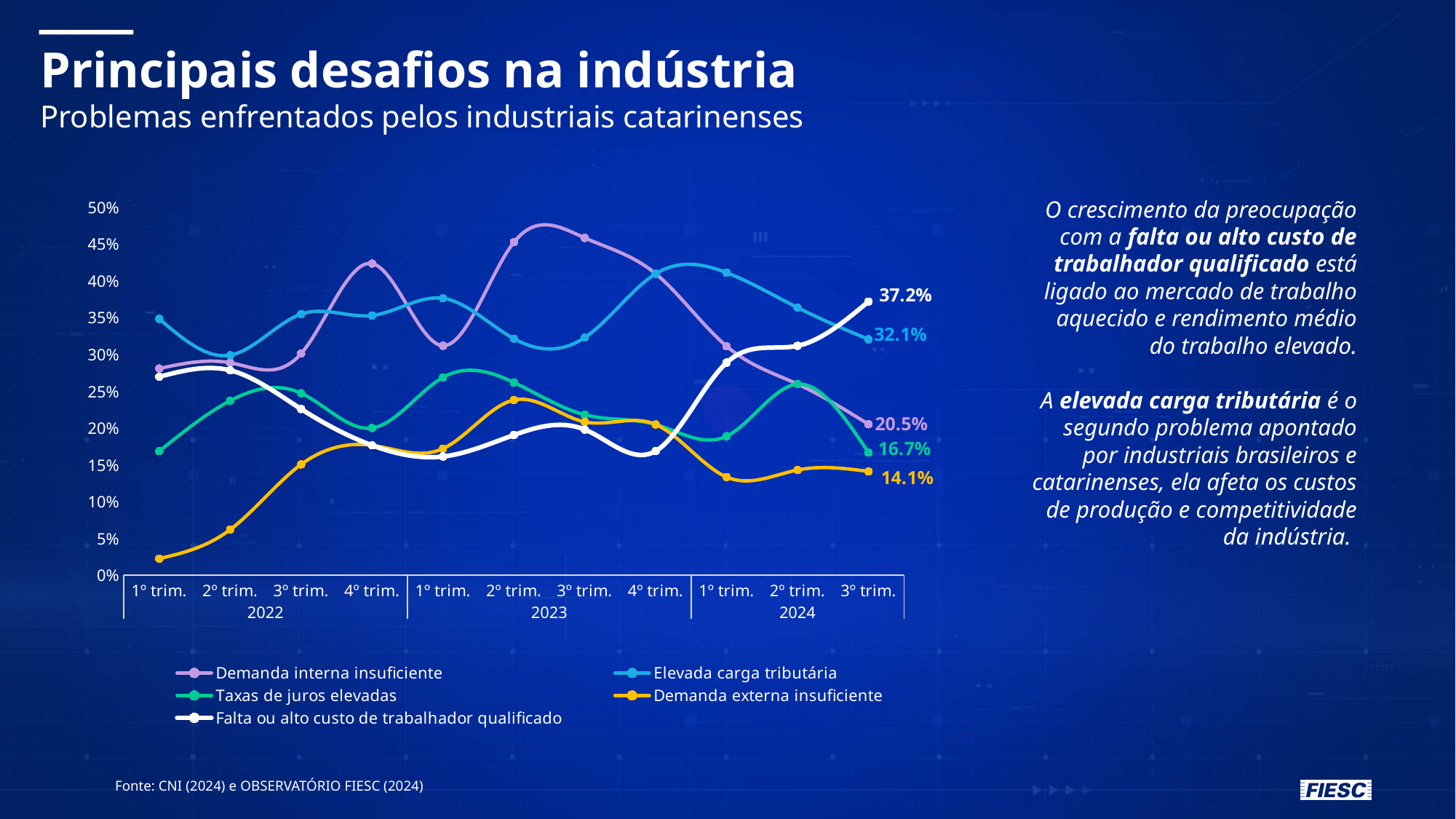
What is the difference between Falta ou alto custo de trabalhador qualificado and Elevada carga tributária in 3º trim. 2024? 5.1 percentage points In 3º trim. 2024, which is larger: Demanda interna insuficiente or Taxas de juros elevadas? Demanda interna insuficiente What is the value for Falta ou alto custo de trabalhador qualificado in 3º trim. 2024? 37.2% How many quarters are plotted on the x axis? 11 How many series does the legend list? 5 What is the value for Elevada carga tributária in 3º trim. 2024? 32.1% Which series has the lowest value in 3º trim. 2024? Demanda externa insuficiente Is the value for Demanda externa insuficiente in 1º trim. 2022 greater or less than 5%? less What kind of chart is shown on the slide? Line chart Which series has the highest value in 3º trim. 2024? Falta ou alto custo de trabalhador qualificado What is the value for Demanda externa insuficiente in 3º trim. 2024? 14.1%